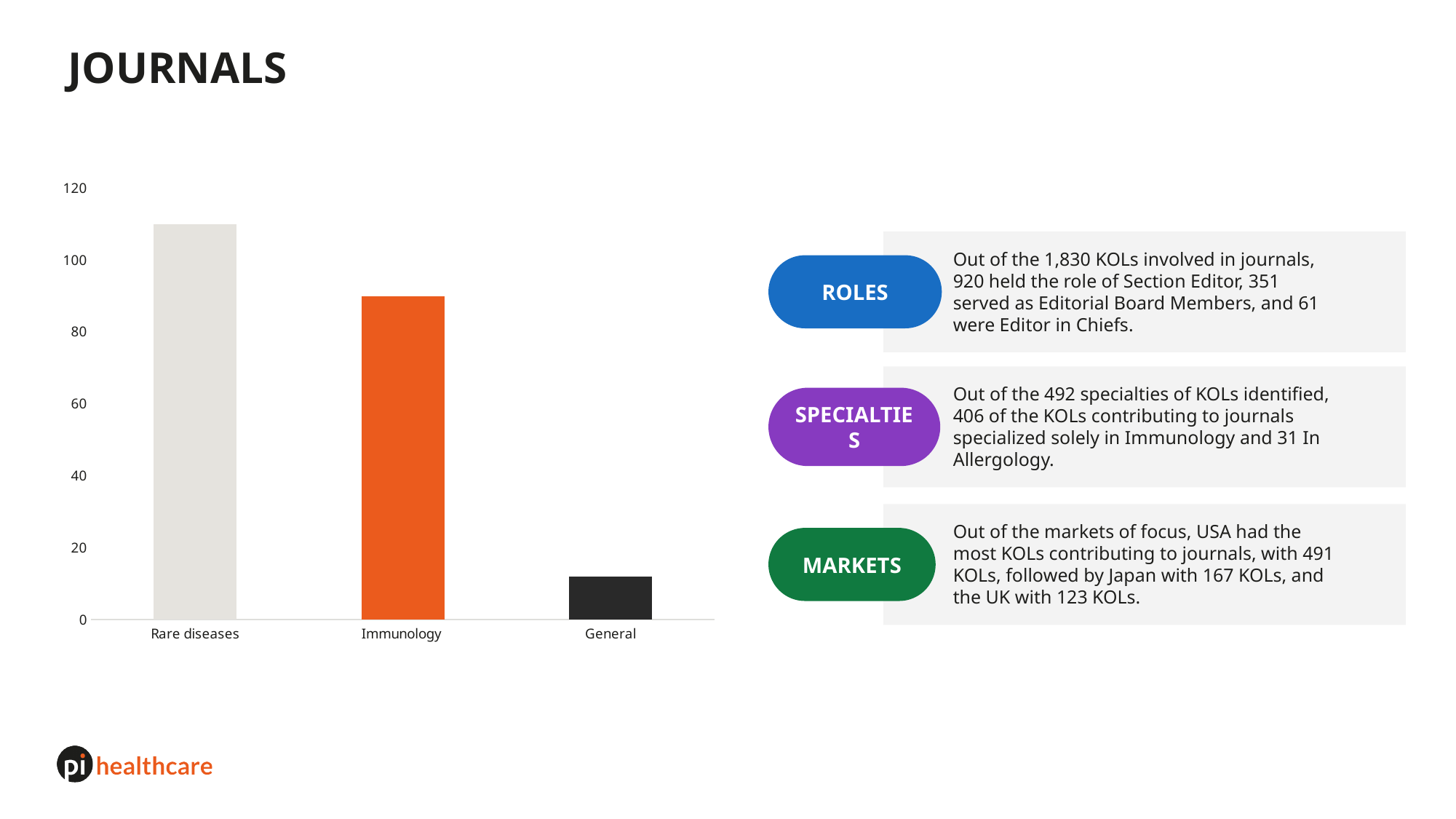
Which category has the highest bar in the chart? Rare diseases Which category has the lowest bar in the chart? General Is the value for Rare diseases greater or less than 100? greater Is the value for Immunology greater or less than 80? greater Do the bar values rise or fall from left to right across the categories? fall How many categories are shown on the x axis of the bar chart? 3 What colour is the bar for Immunology? orange Is the value for Immunology greater or less than 100? less Which is larger, the value for Rare diseases or the value for Immunology? Rare diseases Which is larger, the value for Immunology or the value for General? Immunology What kind of chart is shown on the slide? bar chart